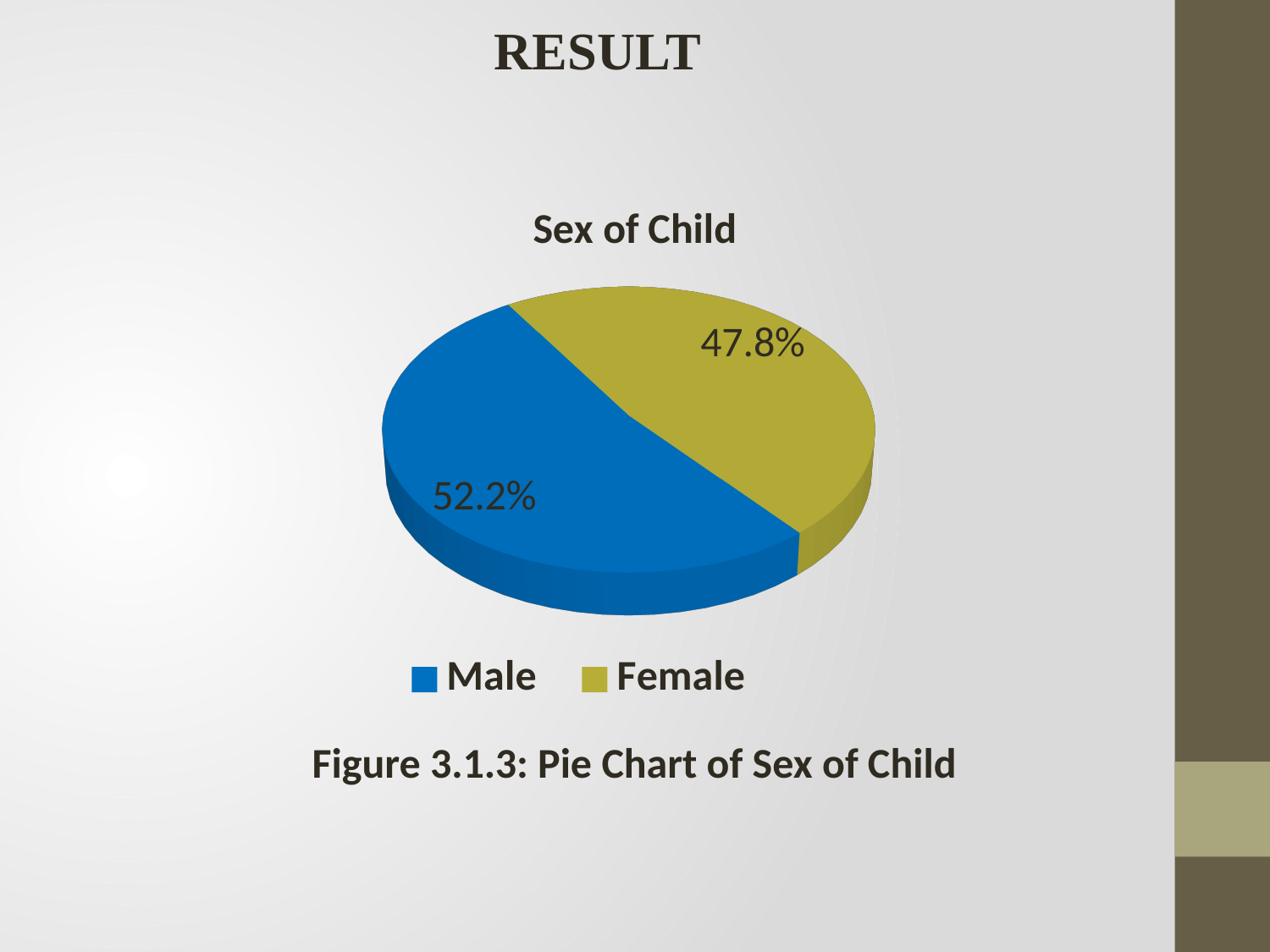
What is the title of the chart? Sex of Child What percentage of the pie is Male? 52.2% Which category has the smallest share of the pie? Female What percentage of the pie is Female? 47.8% What kind of chart is shown on the slide? Pie chart Which category has the largest share of the pie? Male What is the difference in percentage points between the Male and Female shares? 4.4 How many entries does the legend list? 2 Is the Male share greater or less than 50%? greater How many categories does the pie chart have? 2 Which is larger, the Male share or the Female share? Male What colour is the Female slice? Olive green